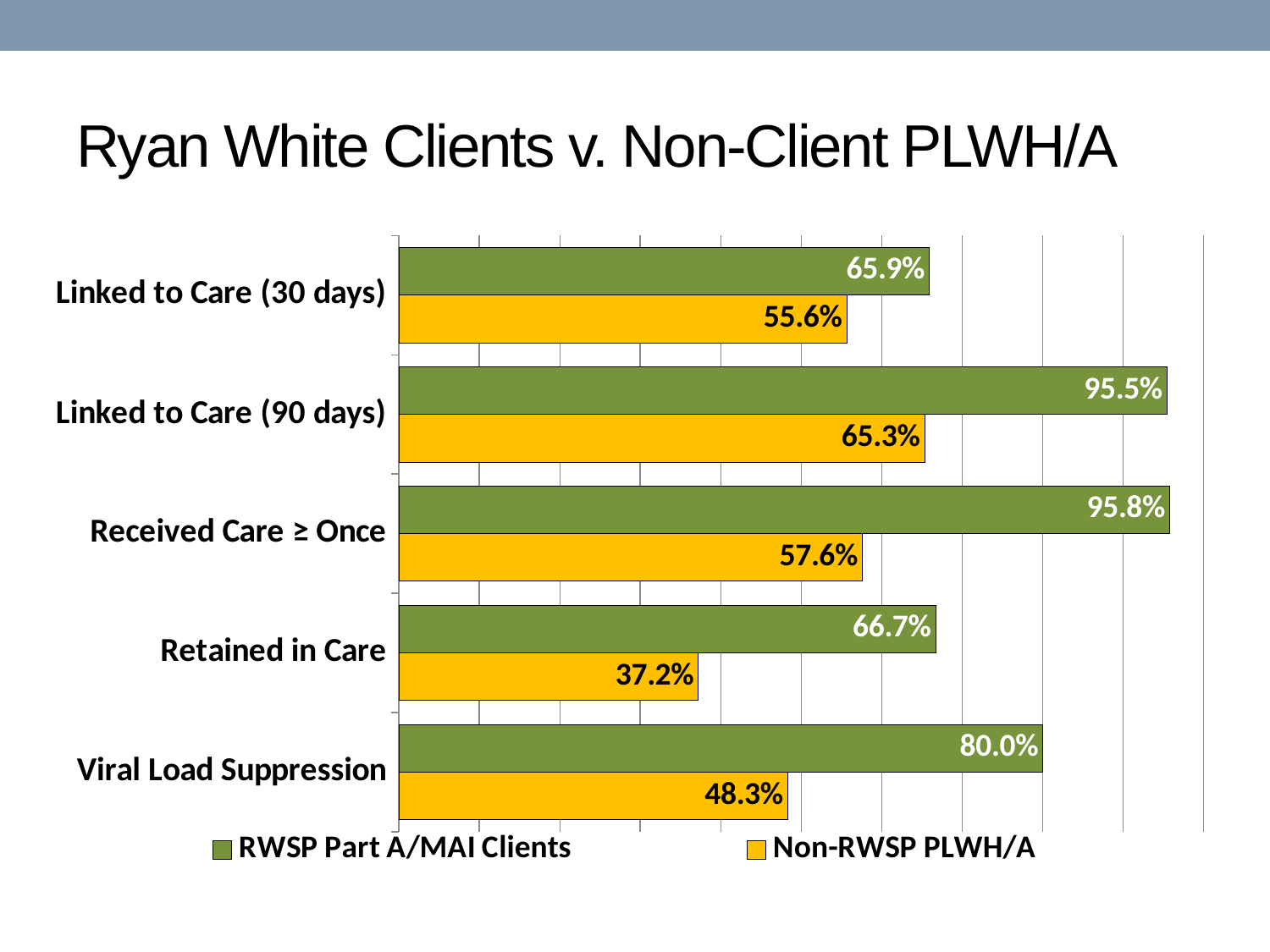
What is the value for Non-RWSP PLWH/A for Retained in Care? 37.2% What is the difference between RWSP Part A/MAI Clients and Non-RWSP PLWH/A for Viral Load Suppression? 31.7% How many series does the legend list? 2 What is the value for RWSP Part A/MAI Clients for Viral Load Suppression? 80.0% What colour represents Non-RWSP PLWH/A in the chart? Yellow Which category has the highest value for RWSP Part A/MAI Clients? Received Care ≥ Once What is the value for Non-RWSP PLWH/A for Linked to Care (90 days)? 65.3% Which category has the lowest value for Non-RWSP PLWH/A? Retained in Care What kind of chart is shown on the slide? Bar chart What is the difference between RWSP Part A/MAI Clients and Non-RWSP PLWH/A for Retained in Care? 29.5% How many categories are shown on the chart? 5 Which is larger for Linked to Care (30 days): RWSP Part A/MAI Clients or Non-RWSP PLWH/A? RWSP Part A/MAI Clients